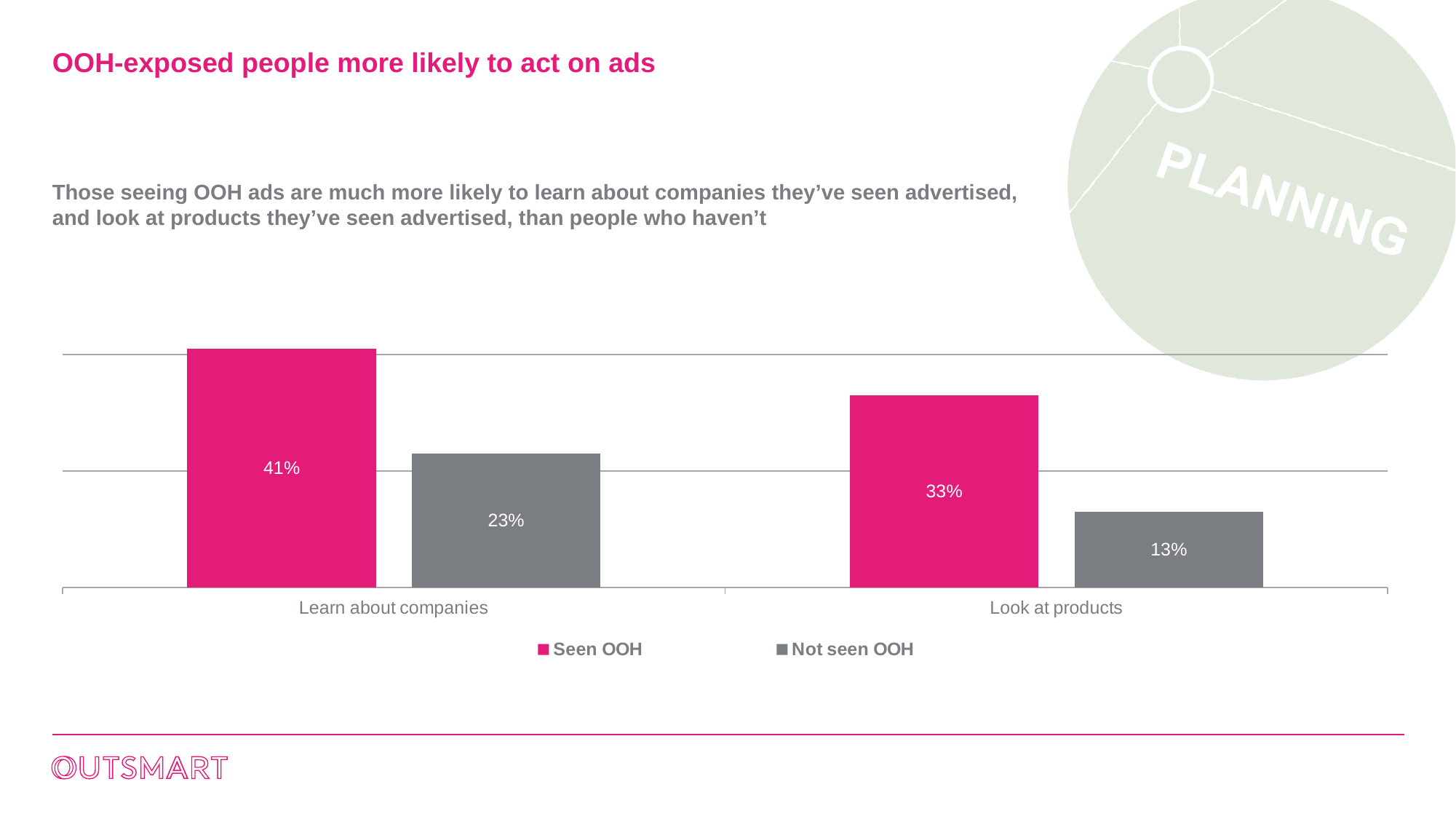
Which bar has the highest value on the chart? Seen OOH, Learn about companies What kind of chart is shown on the slide? Bar chart Which bar has the lowest value on the chart? Not seen OOH, Look at products How many series does the legend list? 2 What is the value for Not seen OOH in the Learn about companies category? 23% What is the value for Not seen OOH in the Look at products category? 13% Which is larger for Look at products: Seen OOH or Not seen OOH? Seen OOH How many categories are shown on the x axis? 2 What is the difference between Seen OOH and Not seen OOH for Learn about companies? 18% What is the value for Seen OOH in the Look at products category? 33% What is the difference between Seen OOH and Not seen OOH for Look at products? 20% What is the value for Seen OOH in the Learn about companies category? 41%